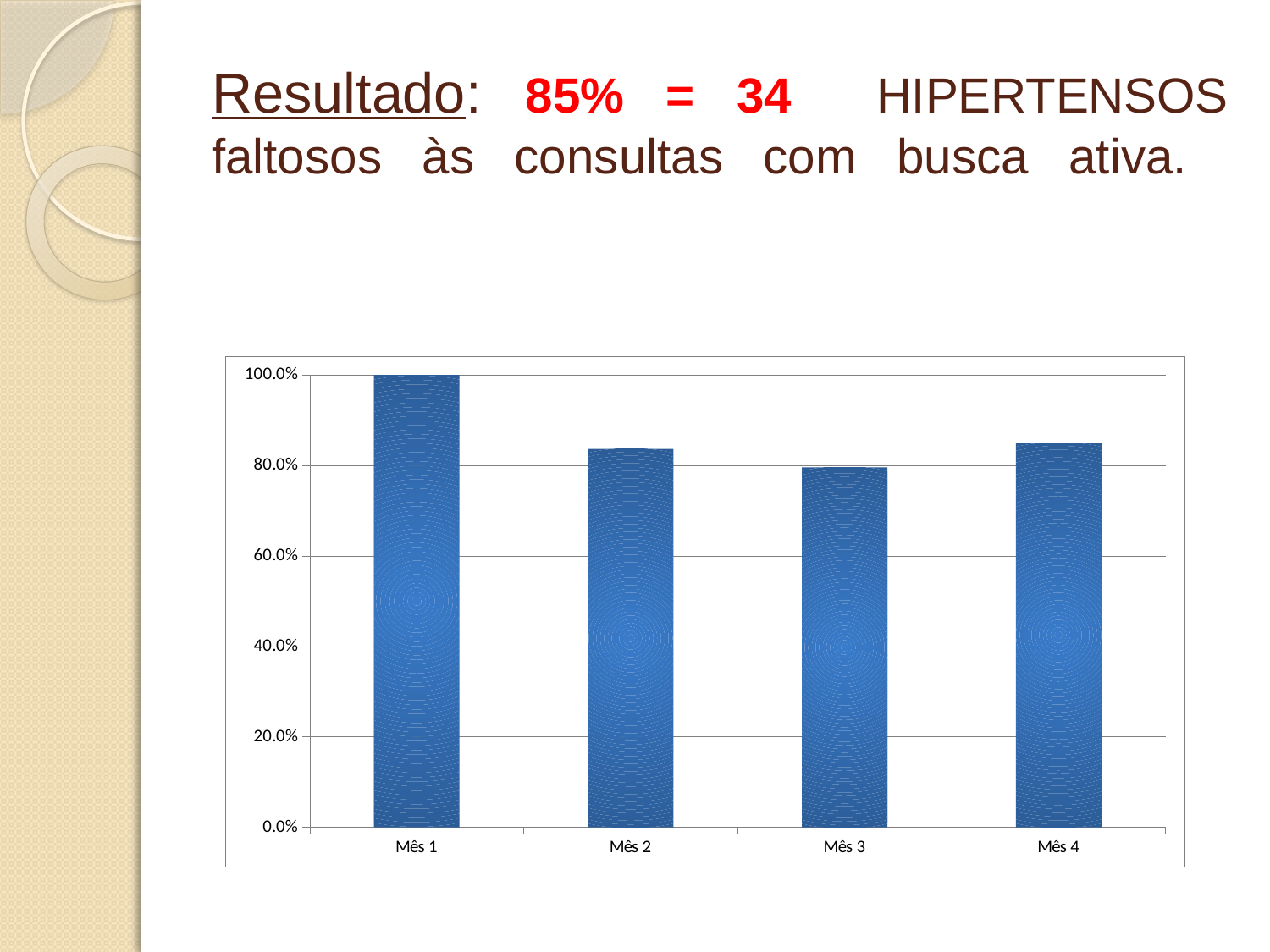
What is the value for Mês 1 in the chart? 100.0% Is the value for Mês 2 greater or less than 80.0%? greater Which month has the lowest value in the chart? Mês 3 Which is larger, the value for Mês 2 or the value for Mês 3? Mês 2 How many categories (months) are shown on the x axis of the chart? 4 Is the value for Mês 4 greater or less than 80.0%? greater What kind of chart is shown on the slide? bar chart Which month has the highest value in the chart? Mês 1 Which is larger, the value for Mês 1 or the value for Mês 3? Mês 1 Is the value for Mês 3 greater or less than 60.0%? greater What colour are the bars in the chart? blue Does the value rise or fall from Mês 1 to Mês 2? fall